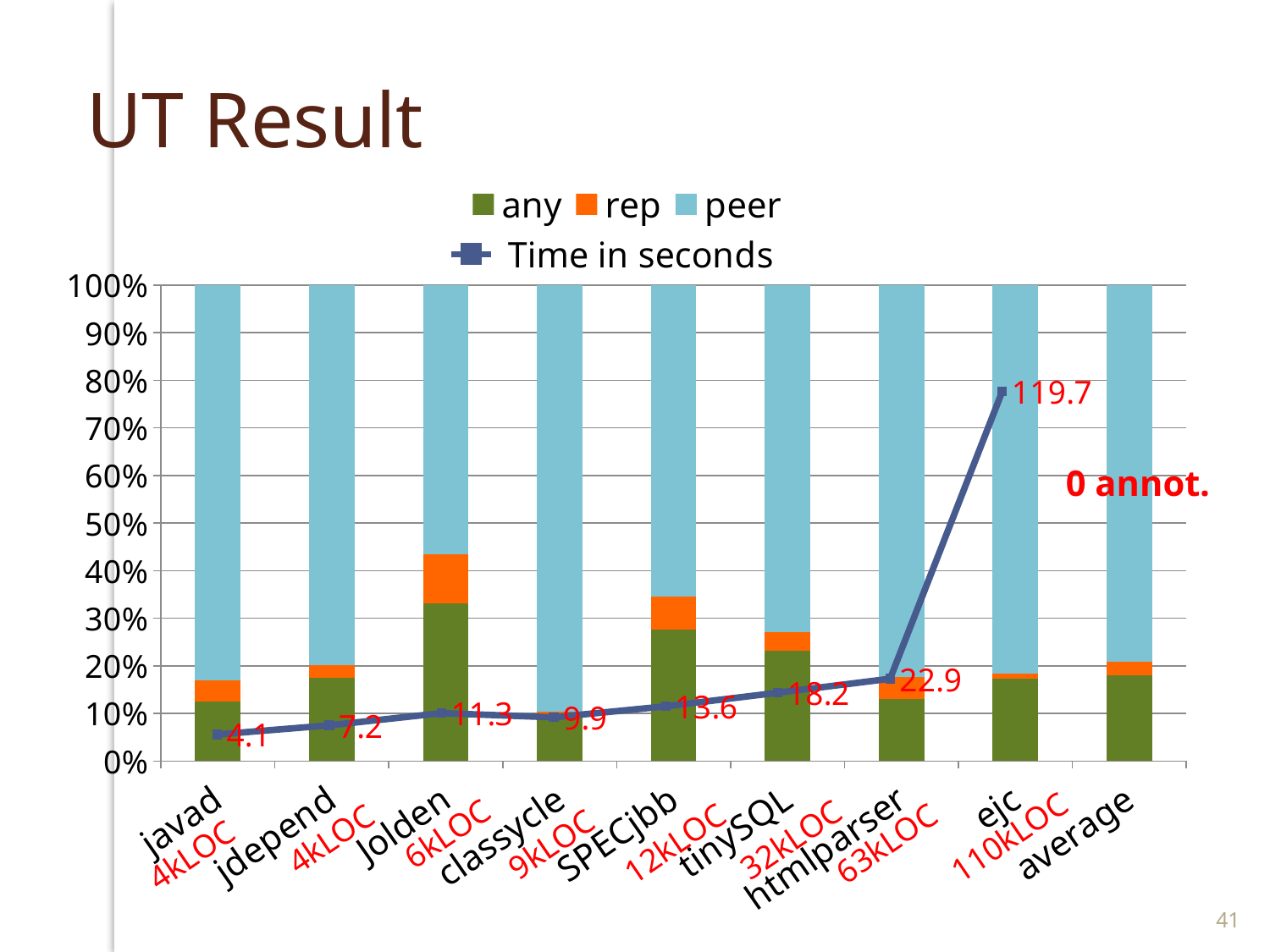
Which has a larger Time in seconds, Jolden or classycle? Jolden Which program has the lowest Time in seconds? javad How many series does the legend list? 4 What is the difference in Time in seconds between ejc and htmlparser? 96.8 How many categories are shown on the x axis? 9 What is the difference in Time in seconds between htmlparser and tinySQL? 4.7 What is the Time in seconds value for ejc? 119.7 What is the Time in seconds value for htmlparser? 22.9 What kind of chart is this? bar chart Is the 'any' share for SPECjbb greater or less than 20%? greater What is the Time in seconds value for javad? 4.1 Which program has the highest Time in seconds? ejc